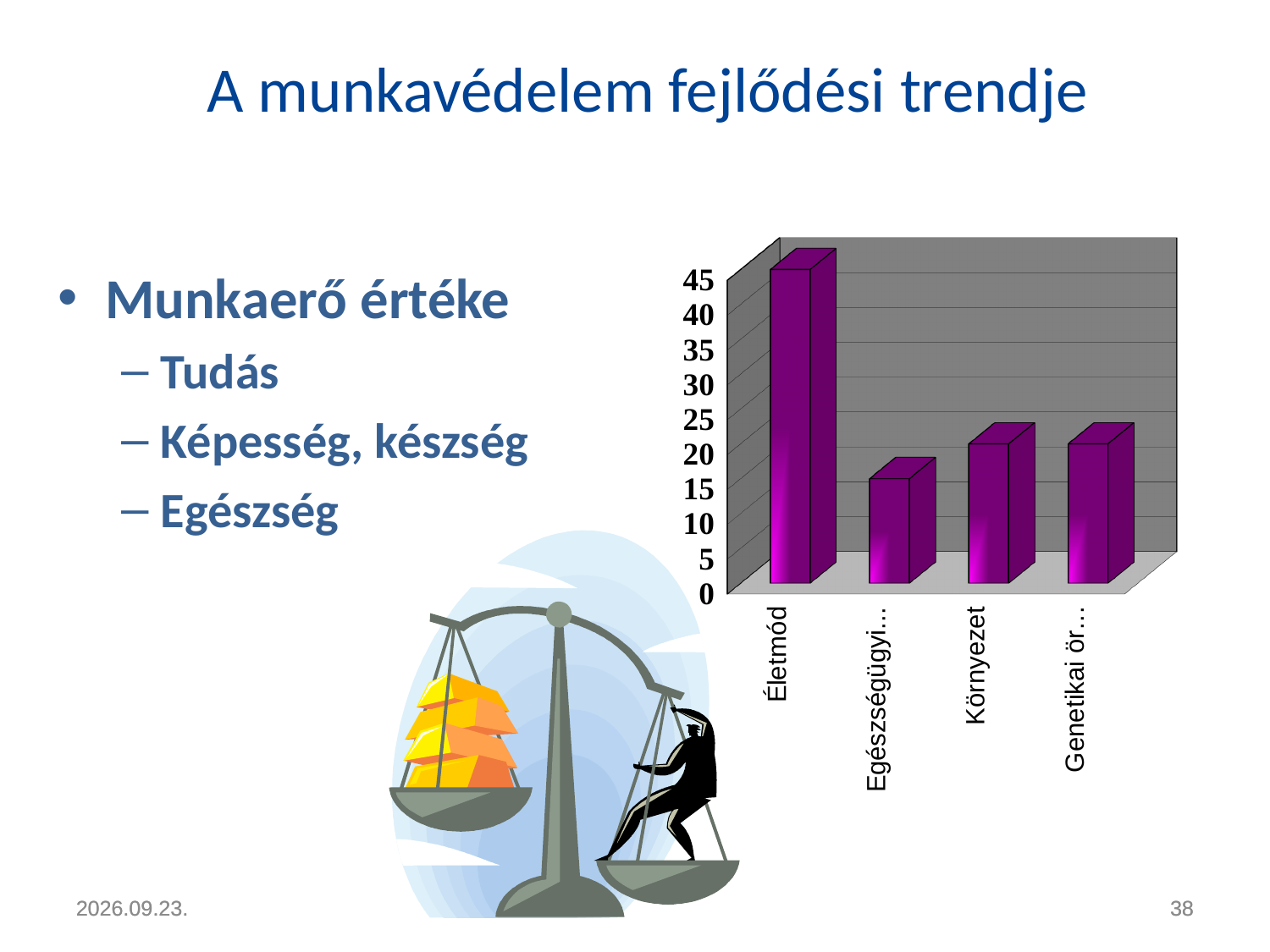
How many categories are plotted in the chart? 4 What colour are the bars in the chart? purple Which is larger, the value for Életmód or the value for Környezet? Életmód Is the value for the fourth bar (Genetikai ör...) greater or less than 25? less What is the highest value labelled on the vertical axis of the chart? 45 Is the value for Környezet greater or less than 15? greater Is the value for the second bar (Egészségügyi...) greater or less than 20? less Which is larger, the value for Környezet or the value for the second bar (Egészségügyi...)? Környezet Which category has the lowest bar in the chart? Egészségügyi... What kind of chart is shown on the slide? bar chart Which category has the highest bar in the chart? Életmód